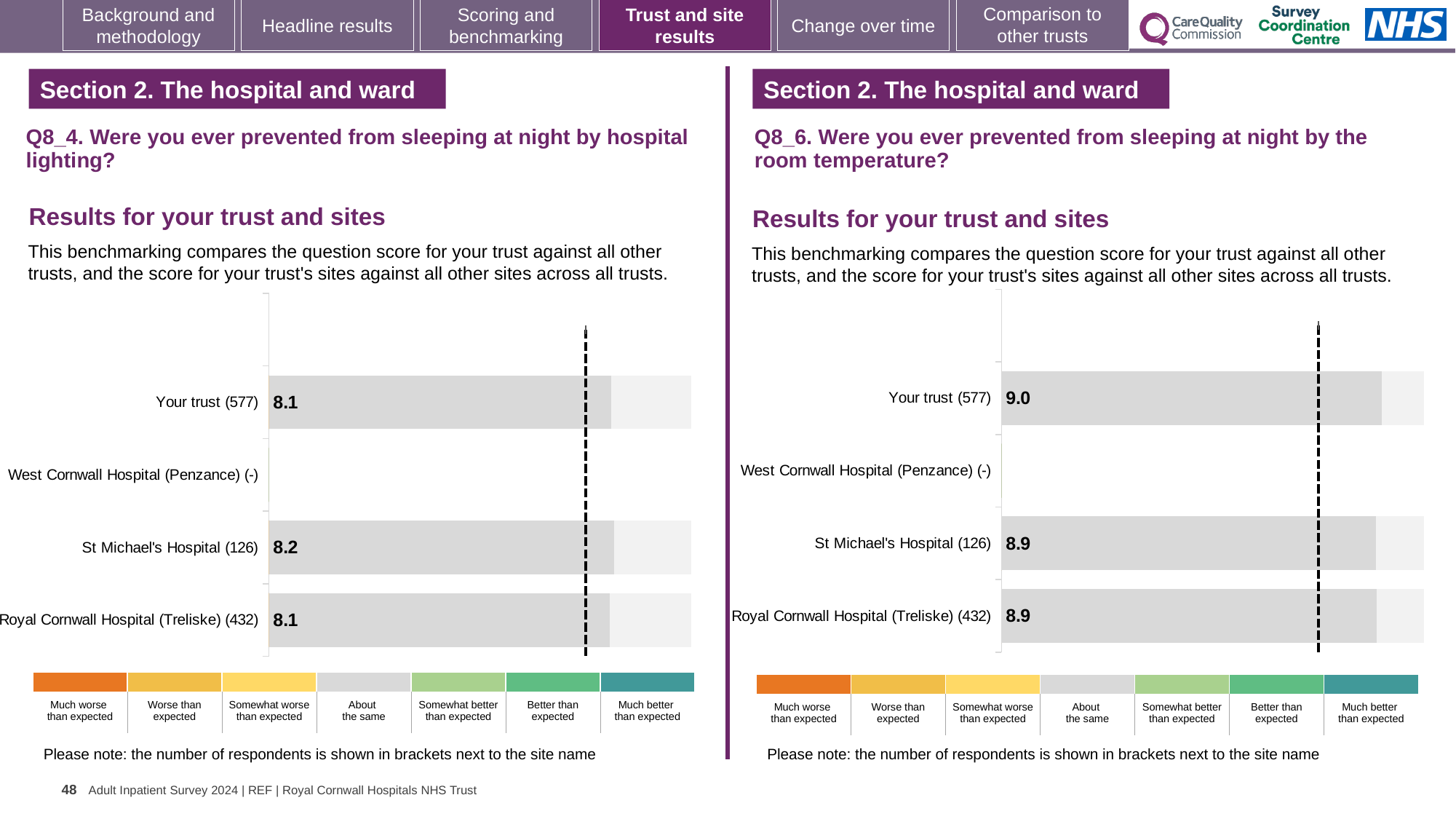
In the Q8_6 chart (room temperature), which is larger: the score for Your trust (577) or Royal Cornwall Hospital (Treliske) (432)? Your trust (577) In the Q8_6 chart (room temperature), what is the difference between the score for Your trust (577) and St Michael's Hospital (126)? 0.1 In the Q8_6 chart (room temperature), what is the score for Your trust (577)? 9.0 How many categories (rows) are listed on the Q8_4 chart (hospital lighting)? 4 In the Q8_6 chart (room temperature), what is the score for St Michael's Hospital (126)? 8.9 What kind of chart is used in the Q8_6 chart (room temperature)? Bar chart In the Q8_4 chart (hospital lighting), which site has the highest score among those with a value shown? St Michael's Hospital (126) In the Q8_4 chart (hospital lighting), what is the score for St Michael's Hospital (126)? 8.2 In the Q8_4 chart (hospital lighting), what is the score for Royal Cornwall Hospital (Treliske) (432)? 8.1 In the Q8_6 chart (room temperature), what is the score for Royal Cornwall Hospital (Treliske) (432)? 8.9 In the Q8_4 chart (hospital lighting), what is the score for Your trust (577)? 8.1 In the Q8_4 chart (hospital lighting), what is the difference between the score for St Michael's Hospital (126) and Your trust (577)? 0.1